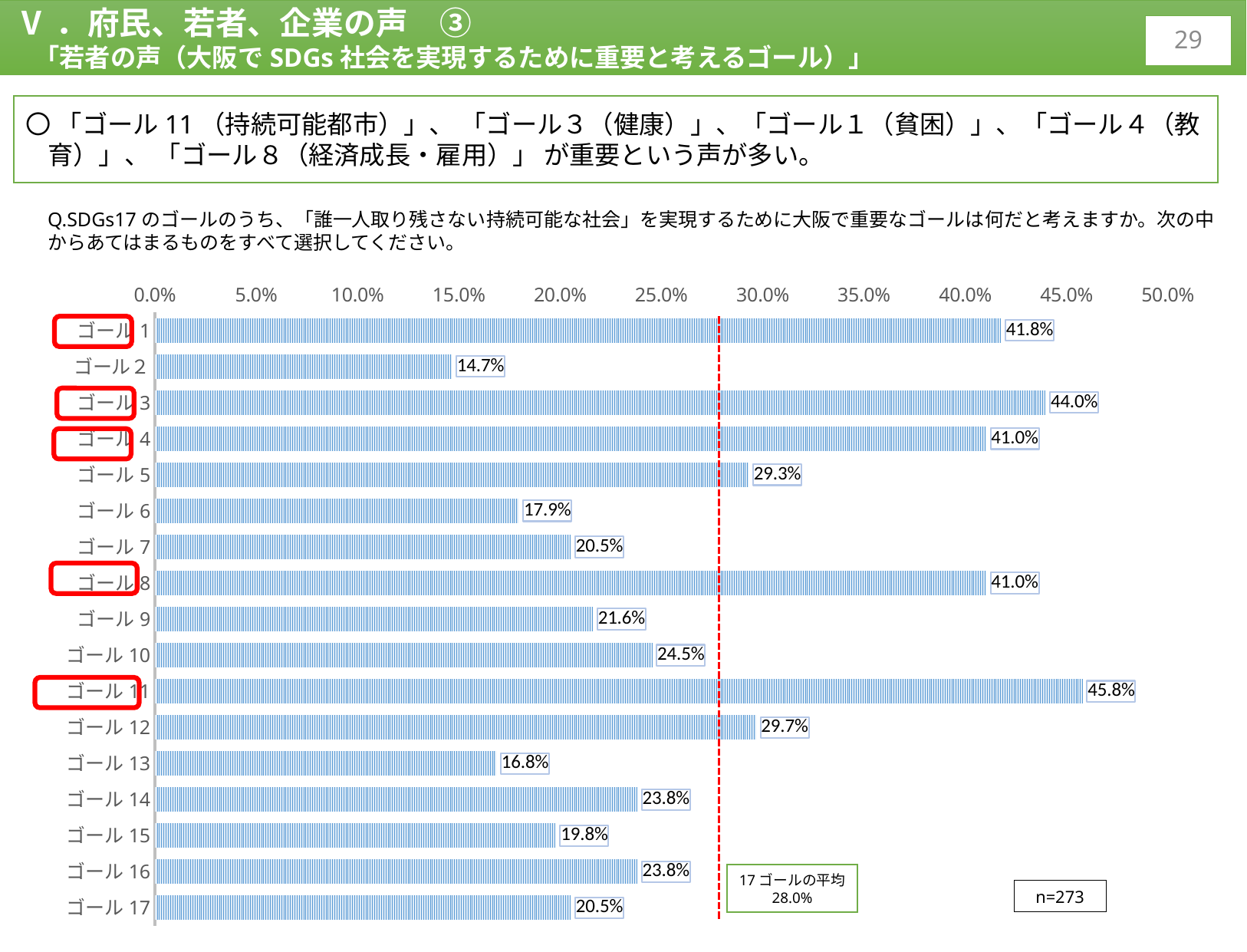
What is the sample size (n) shown on the chart? n=273 Is the value for ゴール 13 greater or less than 20.0%? less What kind of chart is shown on the slide? bar chart What is the value for ゴール 11? 45.8% What is the average of the 17 goals shown by the red dashed line? 28.0% Which is larger, the value for ゴール 5 or the value for ゴール 10? ゴール 5 How many goals (categories) are shown in the chart? 17 What is the value for ゴール 2? 14.7% Which goal has the lowest value? ゴール 2 What is the value for ゴール 12? 29.7% What is the difference between the values for ゴール 3 and ゴール 1? 2.2% Which goal has the highest value? ゴール 11